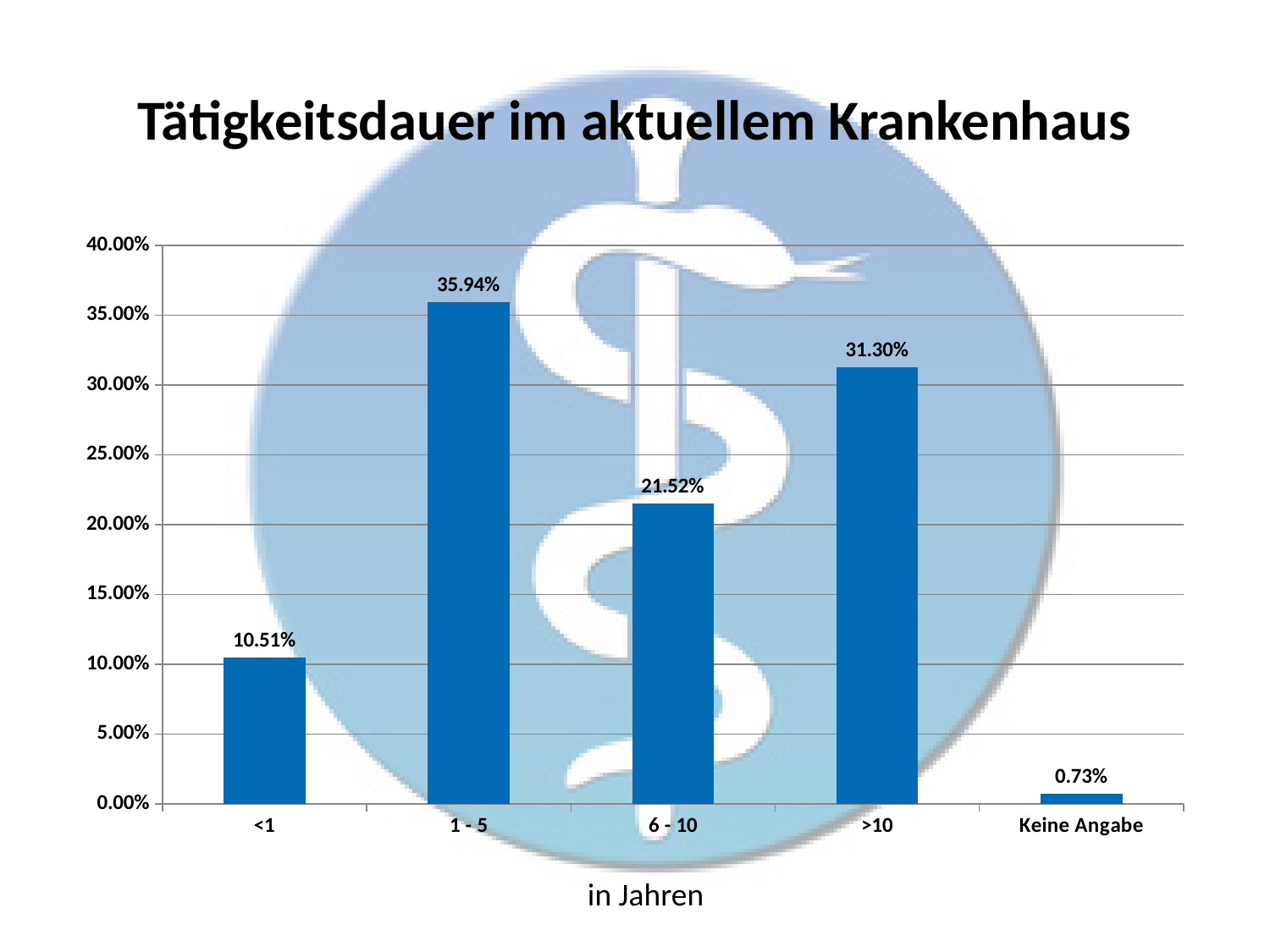
Which is larger, the value for ">10" or the value for "6 - 10"? >10 What is the difference between the values for "1 - 5" and ">10"? 4.64% Which category has the lowest value? Keine Angabe Which category has the highest value? 1 - 5 What is the value for "Keine Angabe"? 0.73% What is the title of the chart? Tätigkeitsdauer im aktuellem Krankenhaus What is the value for the "<1" category? 10.51% What kind of chart is shown on the slide? bar chart How many categories are shown on the x axis? 5 What is the value for the "1 - 5" category? 35.94% Is the value for "6 - 10" greater or less than 25.00%? less What is the difference between the values for "6 - 10" and "<1"? 11.01%